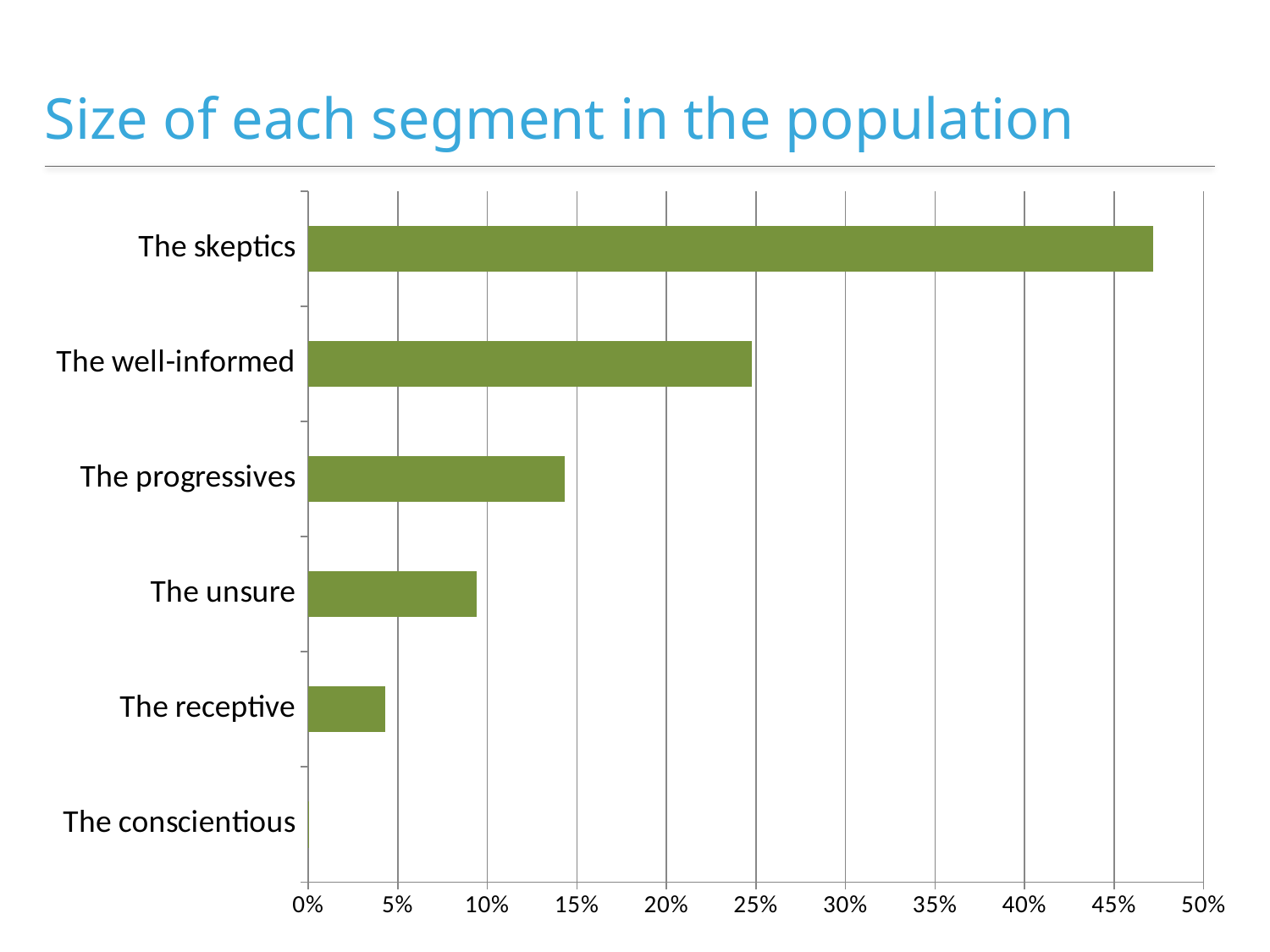
How many segments are shown in the chart? 6 Is the value for The receptive greater or less than 5%? less Which segment has the largest share of the population? The skeptics Is the value for The unsure greater or less than 10%? less Which segment is larger, The skeptics or The well-informed? The skeptics Is the value for The well-informed greater or less than 20%? greater What is the title of the chart? Size of each segment in the population Which segment is larger, The unsure or The progressives? The progressives What kind of chart is shown on the slide? bar chart Which segment has the smallest share of the population? The conscientious